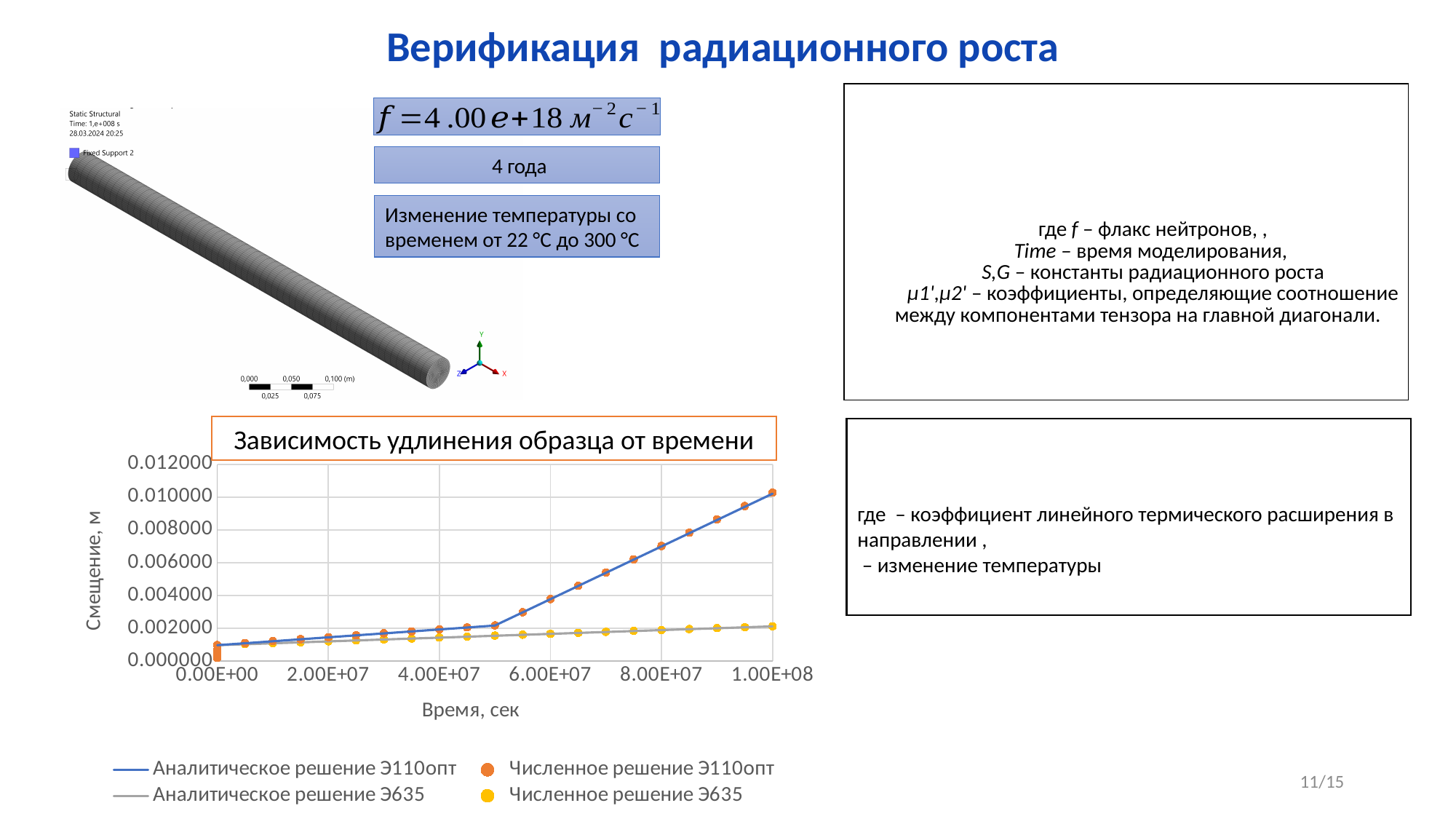
What is the label of the x axis of the chart? Время, сек Is the value for Аналитическое решение Э110опт at 8.00E+07 seconds greater or less than 0.006000? greater How many series does the chart legend list? 4 Is the value for Аналитическое решение Э110опт at 1.00E+08 seconds greater or less than 0.008000? greater What is the title of the chart on the slide? Зависимость удлинения образца от времени Is the value for Аналитическое решение Э110опт at 4.00E+07 seconds greater or less than 0.004000? less At 1.00E+08 seconds, which series has the larger displacement: Аналитическое решение Э110опт or Аналитическое решение Э635? Аналитическое решение Э110опт What kind of chart is shown on the slide? line chart Do the values of the series Аналитическое решение Э635 rise or fall as time increases along the x axis? rise Do the values of the series Аналитическое решение Э110опт rise or fall as time increases along the x axis? rise Which series in the chart is drawn with a blue line? Аналитическое решение Э110опт